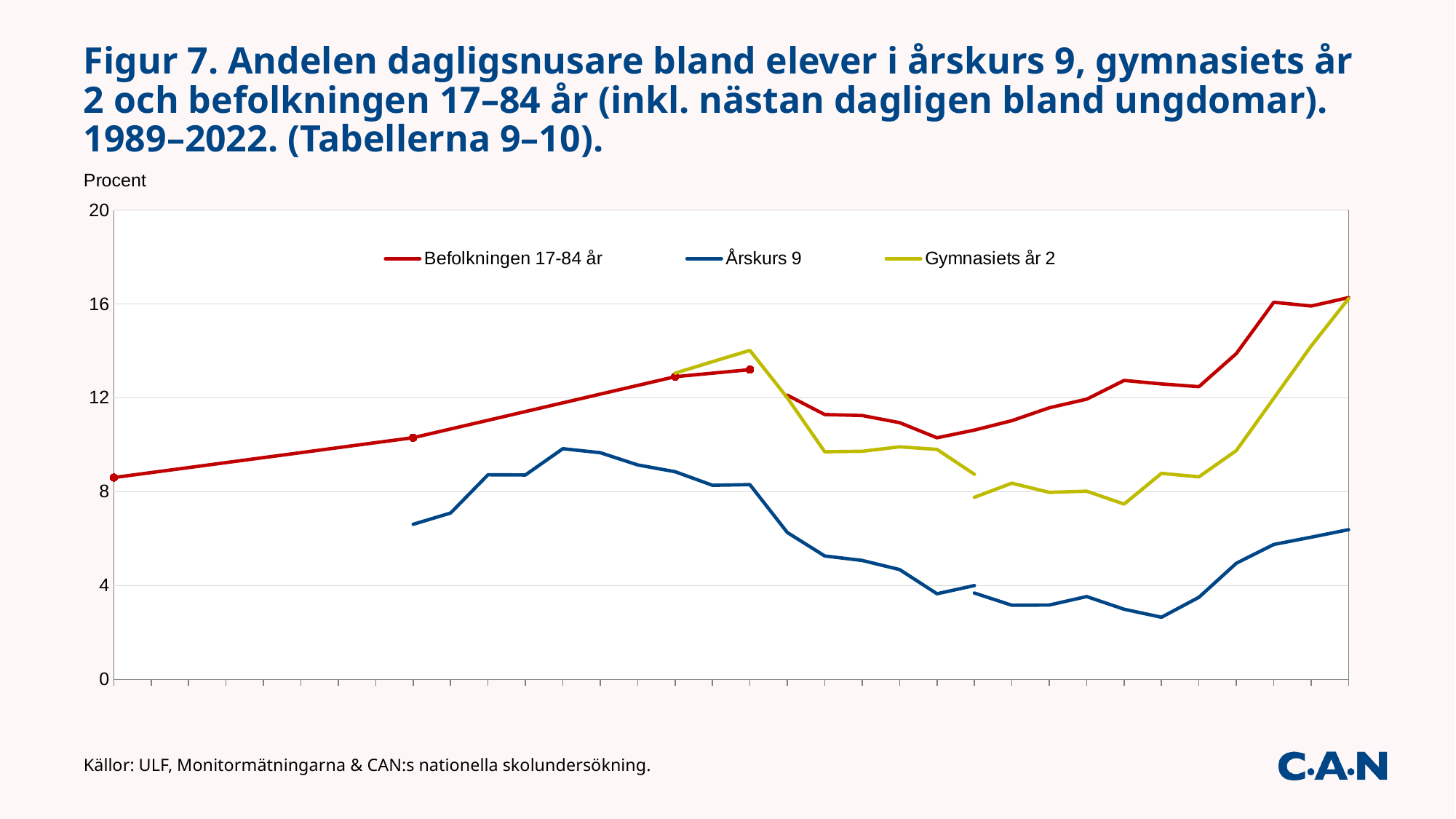
What kind of chart is shown on the slide? line chart Which series has the lowest values on the chart? Årskurs 9 How many series does the legend list? 3 What label is shown on the vertical axis? Procent Is the highest value of Gymnasiets år 2 greater or less than 12? greater Does the Befolkningen 17-84 år series rise or fall from its first point to its last point? rise Is the highest value of Årskurs 9 greater or less than 12? less At the right end of the chart, which is higher: Årskurs 9 or Gymnasiets år 2? Gymnasiets år 2 Is the first value of Befolkningen 17-84 år greater or less than 12? less What colour is the Årskurs 9 line? blue